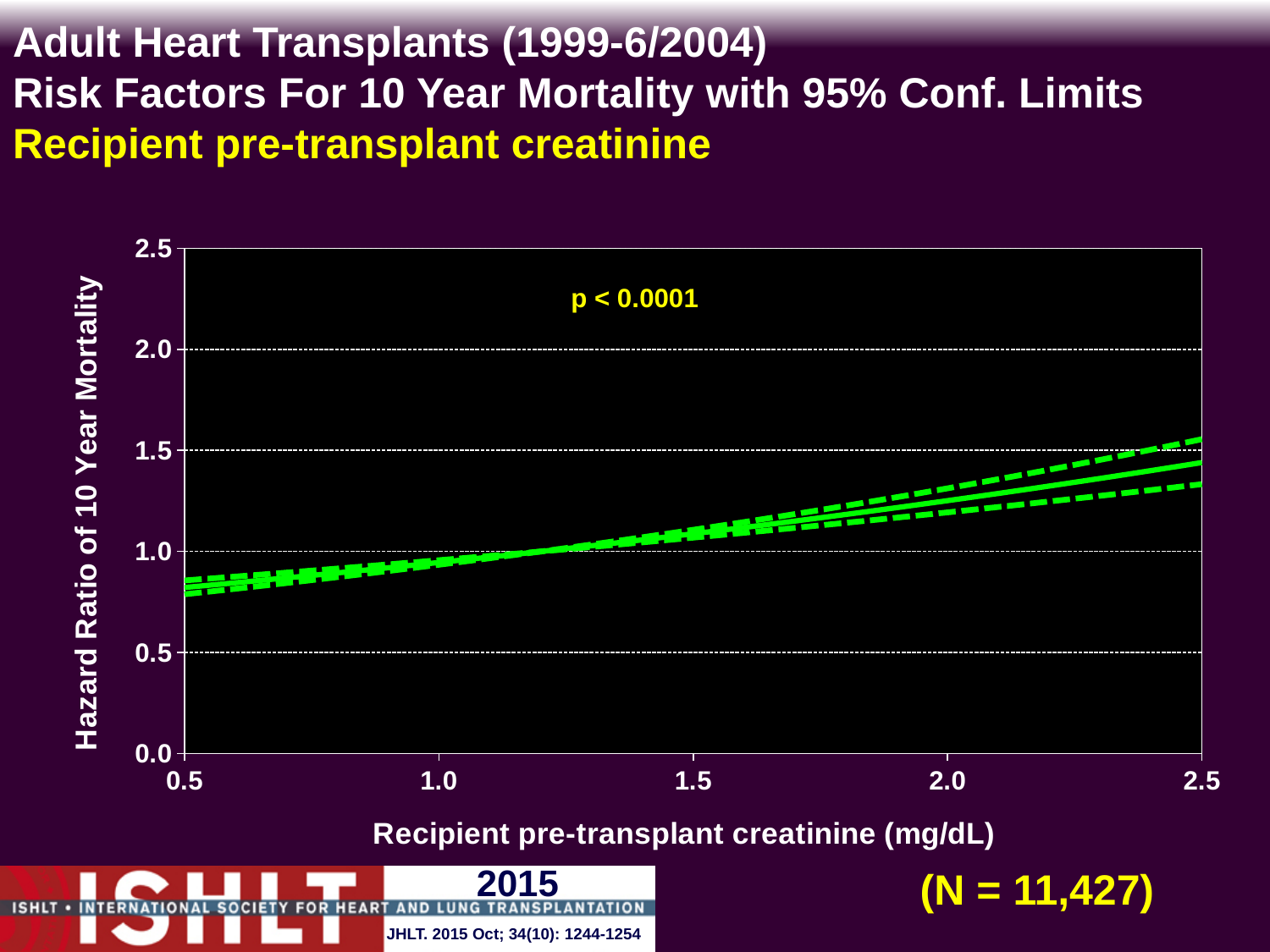
Is the hazard ratio at a recipient pre-transplant creatinine of 2.5 mg/dL greater or less than 2.0? less Is the hazard ratio at a recipient pre-transplant creatinine of 0.5 mg/dL greater or less than 0.5? greater What is the highest value shown on the x axis? 2.5 Which has the higher hazard ratio: a recipient pre-transplant creatinine of 0.5 mg/dL or 2.5 mg/dL? 2.5 mg/dL Is the hazard ratio at a recipient pre-transplant creatinine of 2.5 mg/dL greater or less than 1.0? greater What p-value is printed on the chart? p < 0.0001 What kind of chart is shown on the slide? line chart What is the label of the y axis? Hazard Ratio of 10 Year Mortality What is the highest value shown on the y axis? 2.5 Does the hazard ratio of 10 year mortality rise or fall as recipient pre-transplant creatinine increases from 0.5 to 2.5 mg/dL? rise